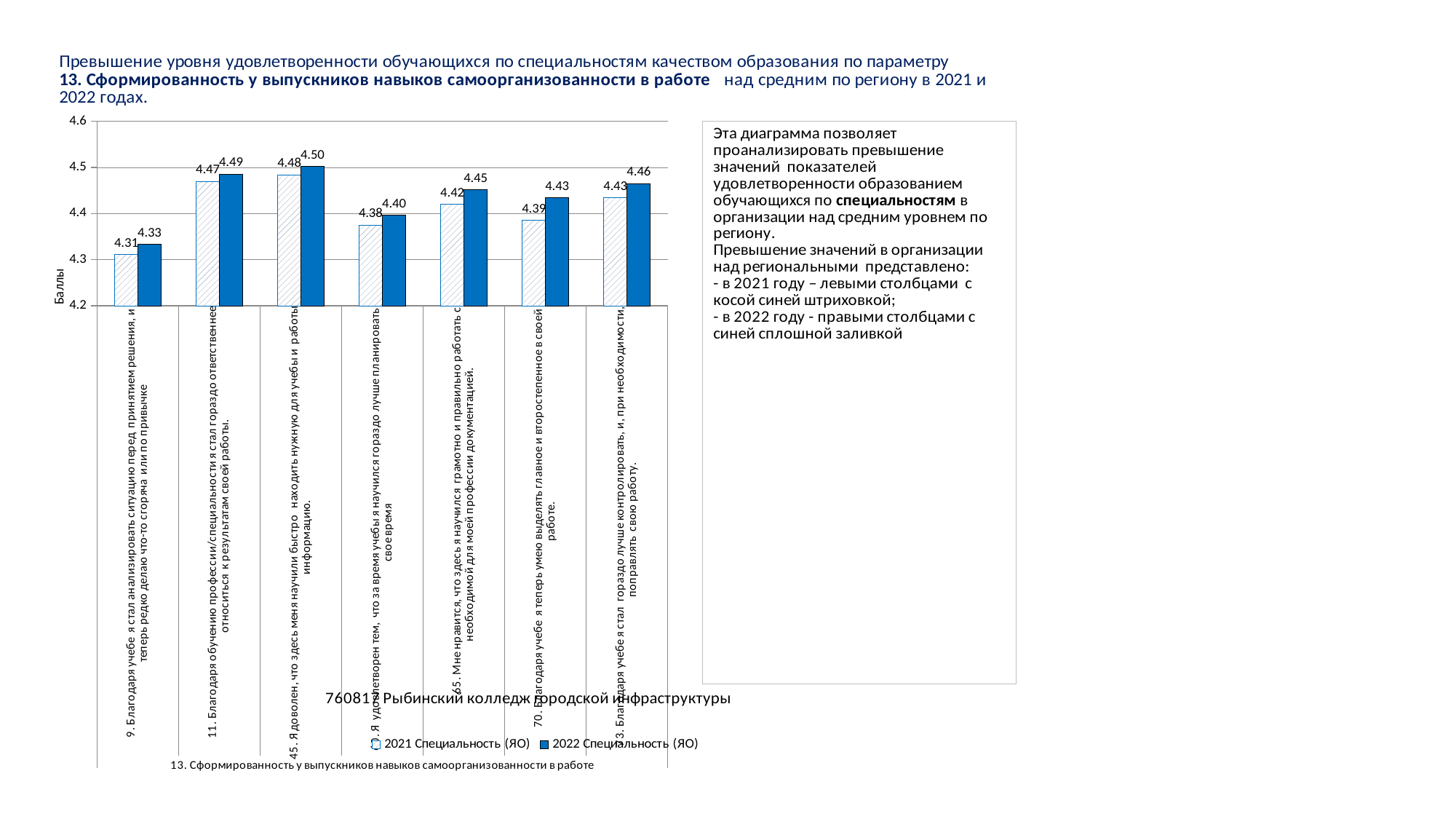
What is the difference between the 2022 and 2021 values for the statement '70. Благодаря учебе я теперь умею выделять главное и второстепенное в своей работе'? 0.04 What is the label of the vertical axis? Баллы Is the 2021 Специальность (ЯО) value for the statement '11. Благодаря обучению профессии/специальности я стал гораздо ответственнее относиться к результатам своей работы' greater or less than 4.4? greater What type of chart is shown on the slide? bar chart What is the 2021 Специальность (ЯО) value for the statement '70. Благодаря учебе я теперь умею выделять главное и второстепенное в своей работе'? 4.39 How many series does the legend list? 2 What is the 2022 Специальность (ЯО) value for the statement '45. Я доволен, что здесь меня научили быстро находить нужную для учебы и работы информацию'? 4.50 What is the 2021 Специальность (ЯО) value for the statement '9. Благодаря учебе я стал анализировать ситуацию перед принятием решения...'? 4.31 How many categories (statements) are plotted on the x axis? 7 Which statement has the highest 2022 Специальность (ЯО) value? 45. Я доволен, что здесь меня научили быстро находить нужную для учебы и работы информацию Which is larger for the statement '65. Мне нравится, что здесь я научился грамотно и правильно работать с необходимой для моей профессии документацией': the 2021 value or the 2022 value? 2022 value Which statement has the lowest 2021 Специальность (ЯО) value? 9. Благодаря учебе я стал анализировать ситуацию перед принятием решения, и теперь редко делаю что-то сгоряча или по привычке